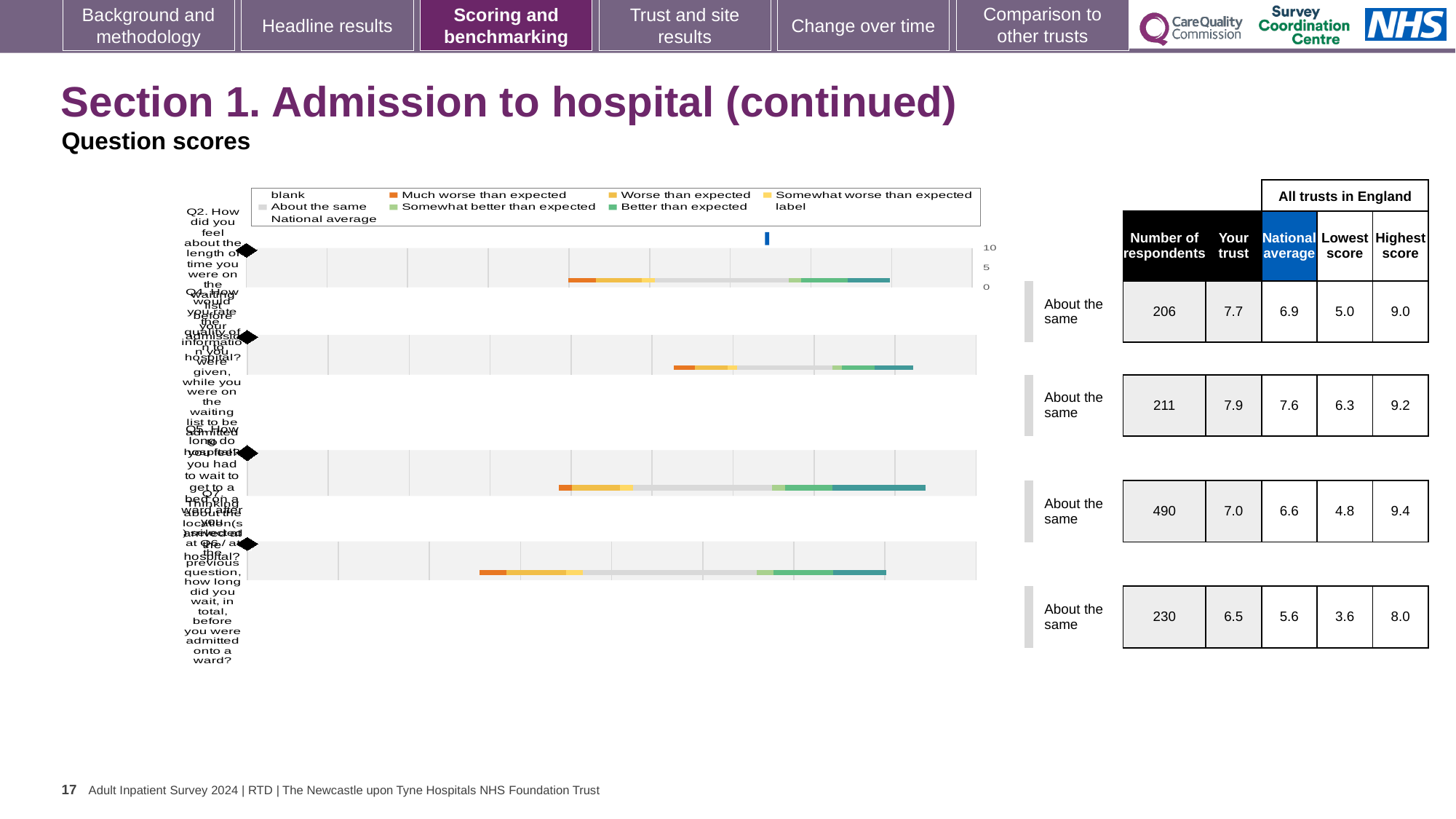
In the third row (490 respondents), which is larger: the 'Your trust' score or the national average? Your trust What is the highest score for the last row (230 respondents)? 8.0 Which row has the highest 'Your trust' score? the second row (211 respondents), 7.9 What is the lowest score for the row with 490 respondents? 4.8 What is the 'Your trust' score for the first row (206 respondents)? 7.7 Which row has the lowest 'Your trust' score? the fourth row (230 respondents), 6.5 What is the national average for the row with 211 respondents? 7.6 What kind of chart is shown on the slide? bar chart Which column header in the table is highlighted in blue? National average How many question rows are plotted in the chart? 4 What benchmark category is shown for every question row? About the same For the first row, how much higher is the 'Your trust' score than the national average? 0.8